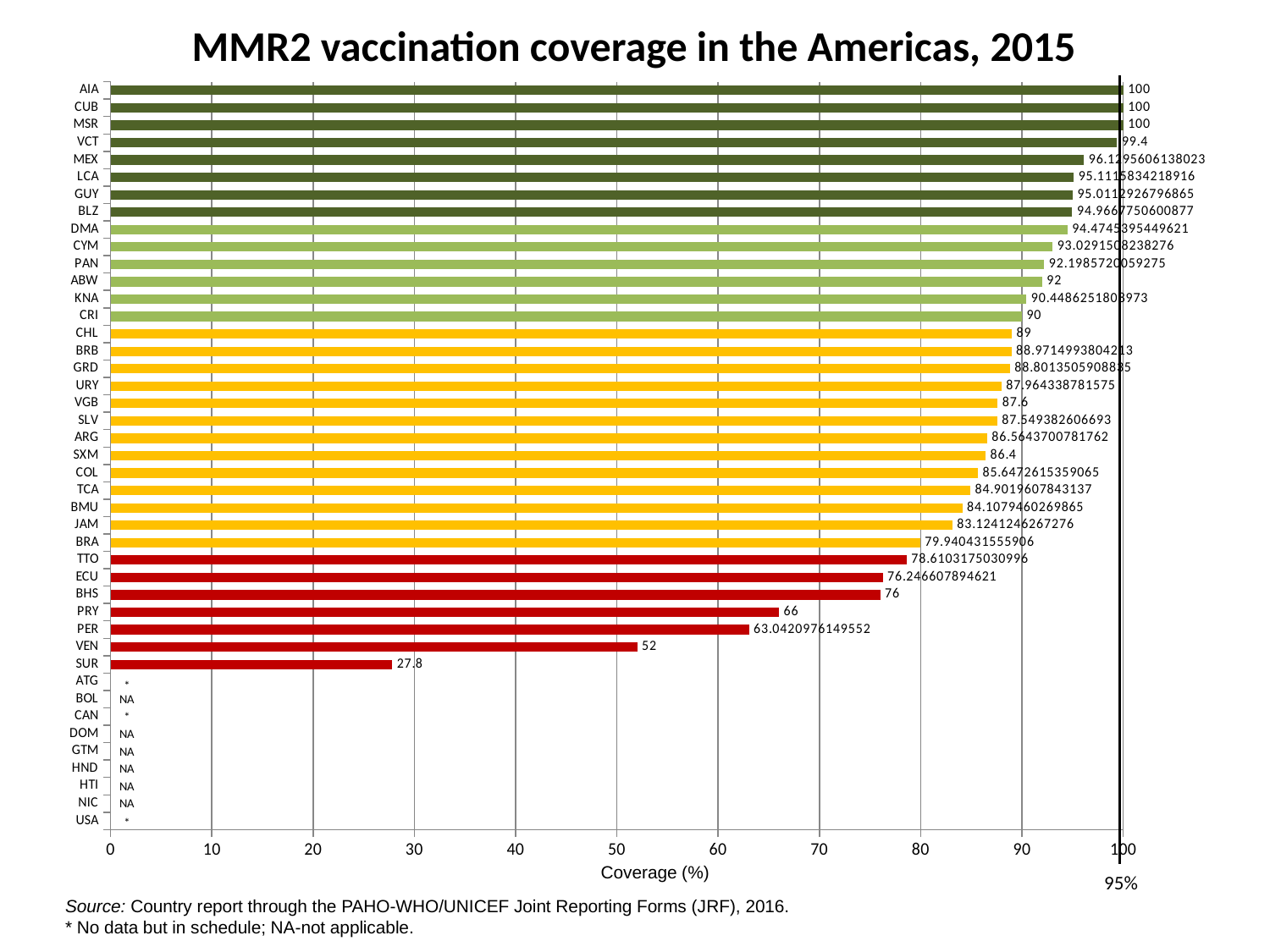
What is the difference between the coverage values for BHS and PRY? 10 What is the MMR2 vaccination coverage value shown for VCT? 99.4 Which has a higher coverage value, PRY or VEN? PRY What is the label of the x axis? Coverage (%) What kind of chart is shown on the slide? bar chart What coverage value is shown for ABW? 92 What coverage value is shown for SUR? 27.8 How many countries are marked NA on the chart? 6 What is the highest coverage value shown on the chart? 100 Which country has the lowest plotted coverage value? SUR What coverage value is shown for VGB? 87.6 Is the coverage value for PER greater or less than 60? greater